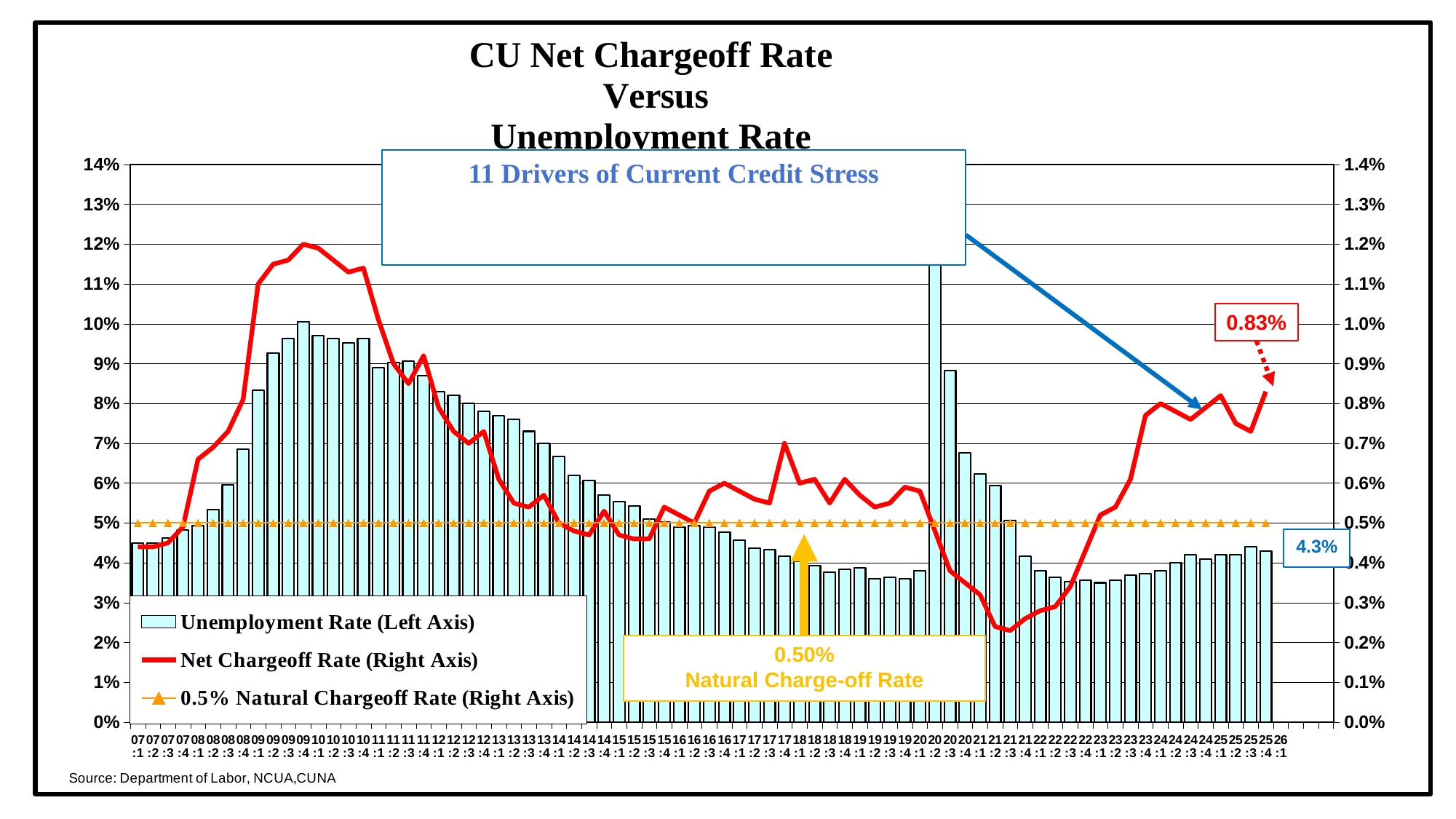
Is the Net Chargeoff Rate for 09:4 greater or less than 1.1%? greater What is the most recent Unemployment Rate value labeled on the chart? 4.3% What is the most recent Net Chargeoff Rate value labeled on the chart? 0.83% Which has the larger Unemployment Rate, 09:4 or 14:1? 09:4 What value is given for the Natural Charge-off Rate? 0.50% Is the Net Chargeoff Rate for 21:3 greater or less than 0.3%? less What is the title of the chart? CU Net Chargeoff Rate Versus Unemployment Rate What kind of chart is shown on the slide? A combination bar and line chart How many series does the legend list? 3 Which quarter has the highest Unemployment Rate bar? 20:2 Does the Unemployment Rate rise or fall from 10:1 to 19:4? fall